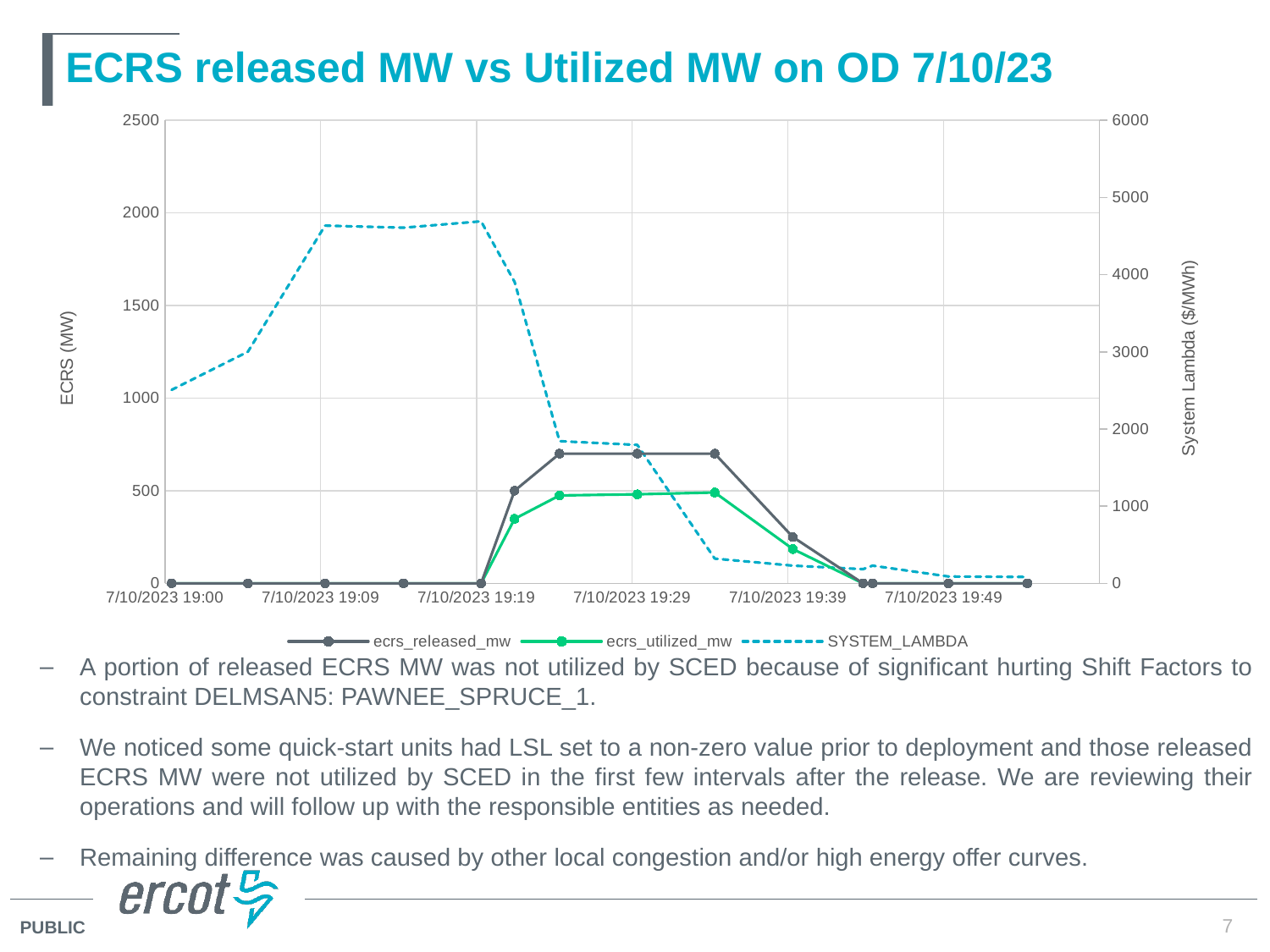
Is the value of ecrs_utilized_mw at 7/10/2023 19:29 greater or less than 1000? less Does SYSTEM_LAMBDA rise or fall between 7/10/2023 19:29 and 7/10/2023 19:49? fall What is the title of the chart? ECRS released MW vs Utilized MW on OD 7/10/23 Does ecrs_released_mw rise or fall between 7/10/2023 19:19 and 7/10/2023 19:29? rise What is the label of the left vertical axis? ECRS (MW) Is the value of ecrs_released_mw at 7/10/2023 19:29 greater or less than 500? greater How many series does the chart legend list? 3 At 7/10/2023 19:29, which series has the larger value, ecrs_released_mw or ecrs_utilized_mw? ecrs_released_mw What kind of chart is shown on the slide? line chart Is the value of SYSTEM_LAMBDA at 7/10/2023 19:09 greater or less than 4000? greater What is the value of ecrs_released_mw at 7/10/2023 19:00? 0